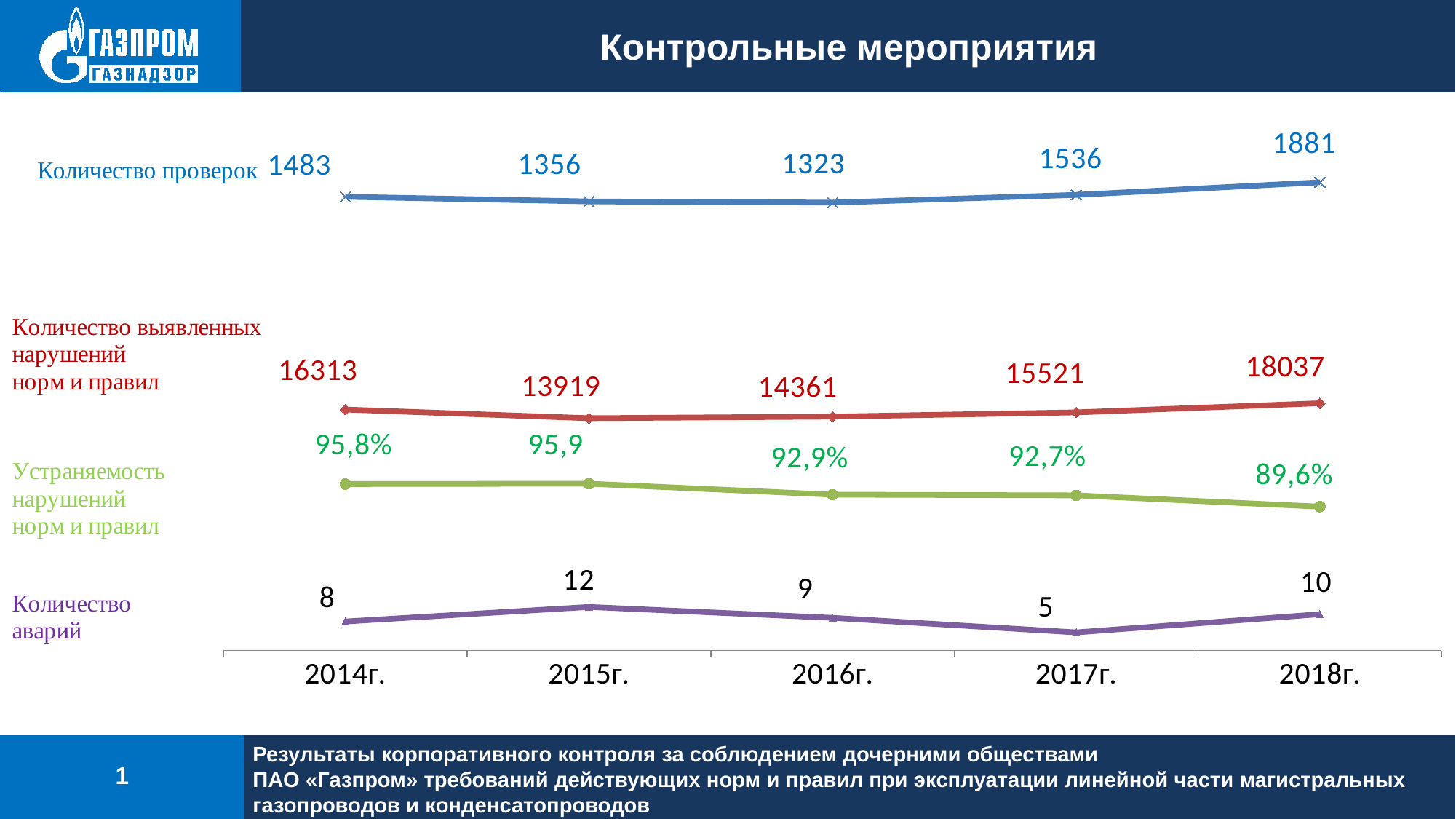
What is the value of 'Количество выявленных нарушений норм и правил' for 2015г.? 13919 What is the difference between 'Количество выявленных нарушений норм и правил' in 2018г. and 2017г.? 2516 In which year is 'Количество аварий' highest? 2015г. In which year is 'Количество проверок' lowest? 2016г. What is the value of 'Количество проверок' for 2018г.? 1881 What is the value of 'Устраняемость нарушений норм и правил' for 2016г.? 92,9% How many years are shown on the x axis of the chart? 5 What is the value of 'Количество аварий' for 2017г.? 5 What type of chart is shown on the slide? line chart Does 'Устраняемость нарушений норм и правил' rise or fall from 2015г. to 2018г.? fall What is the title of the slide containing the chart? Контрольные мероприятия Which is larger: 'Количество проверок' in 2014г. or in 2015г.? 2014г.